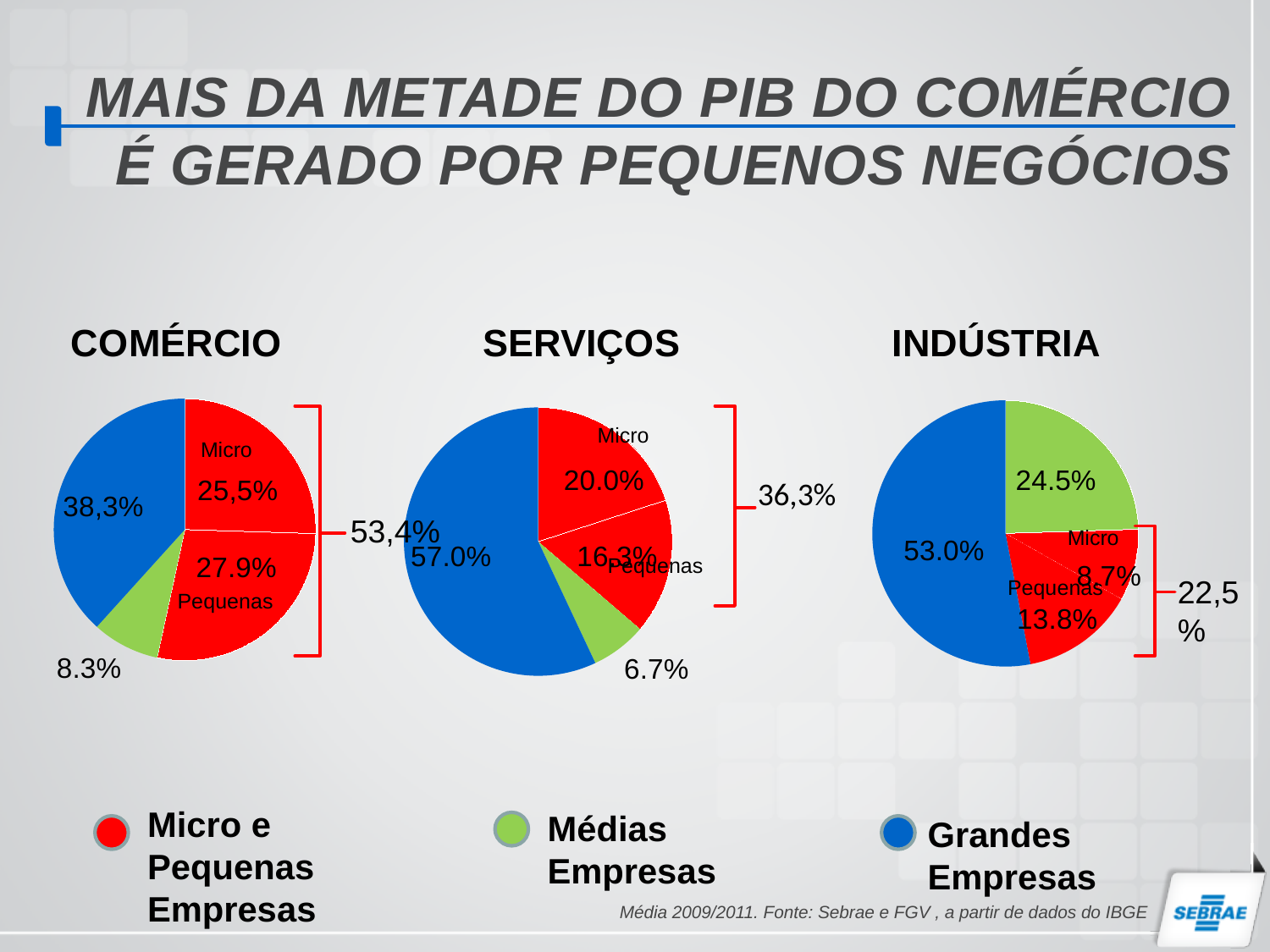
What is the combined share of Micro and Pequenas shown by the bracket next to the COMÉRCIO pie chart? 53,4% How many pie charts are shown on the slide? 3 In the COMÉRCIO pie chart, what value is shown on the blue (Grandes Empresas) slice? 38,3% In the SERVIÇOS pie chart, what value is shown on the blue (Grandes Empresas) slice? 57.0% In the SERVIÇOS pie chart, which slice is the smallest? Médias Empresas (6.7%) In the SERVIÇOS pie chart, what share is labelled for Micro? 20.0% In the INDÚSTRIA pie chart, what share is labelled for Pequenas? 13.8% Which is larger: the Grandes Empresas slice in the SERVIÇOS chart or the Grandes Empresas slice in the INDÚSTRIA chart? SERVIÇOS (57.0%) In the COMÉRCIO pie chart, what share is labelled for Micro? 25,5% In the INDÚSTRIA pie chart, what value is shown on the green (Médias Empresas) slice? 24.5% In the INDÚSTRIA pie chart, which slice is the largest? Grandes Empresas (53.0%) In the COMÉRCIO pie chart, what share is labelled for Pequenas? 27.9%